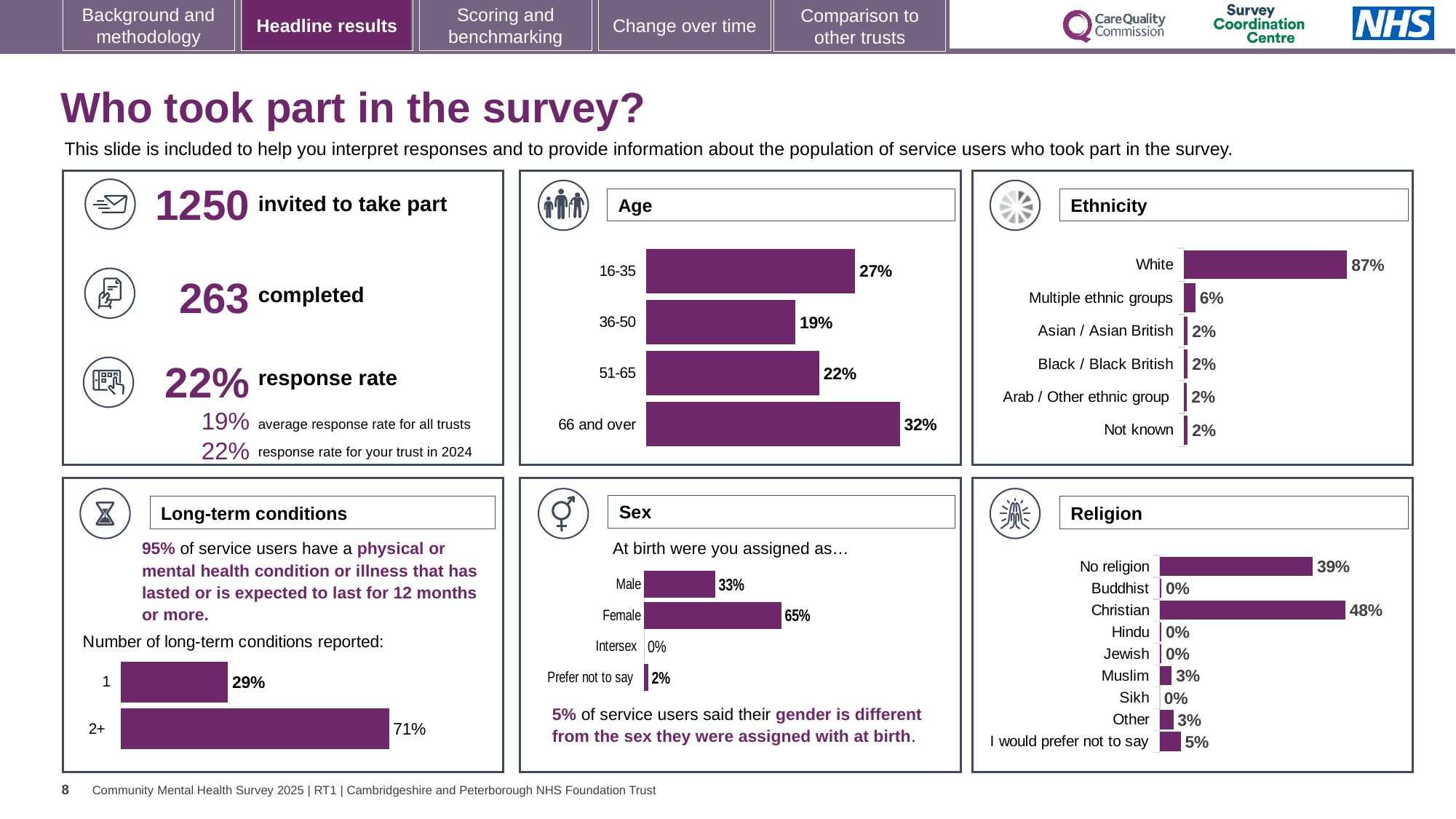
In the Ethnicity chart, how many ethnicity categories are shown? 6 In the Age chart, what percentage of respondents were aged 66 and over? 32% In the Ethnicity chart, what is the value for Multiple ethnic groups? 6% In the Long-term conditions chart, what percentage of service users reported 2+ long-term conditions? 71% In the Sex chart, which is larger, Male or Female? Female In the Sex chart, what percentage of respondents answered Prefer not to say? 2% In the Age chart, what is the difference between the 16-35 and 36-50 percentages? 8% In the Age chart, which age group has the lowest percentage? 36-50 What type of chart is used in the Age panel? Bar chart In the Religion chart, which religion category has the highest percentage? Christian In the Ethnicity chart, what percentage of respondents were White? 87% In the Religion chart, what is the difference between Christian and No religion? 9%